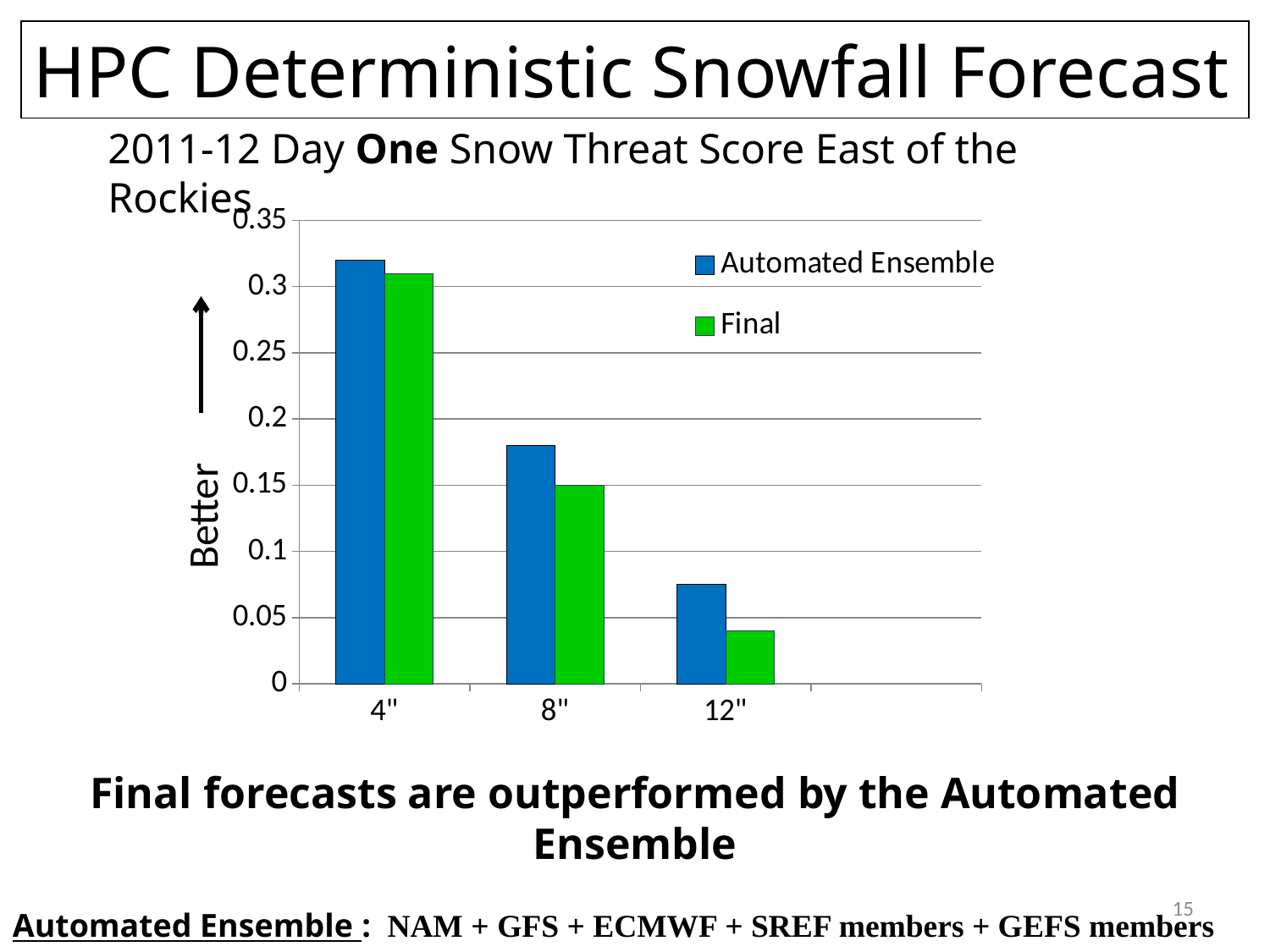
At 12", which is larger, the Automated Ensemble score or the Final score? Automated Ensemble How many snowfall categories are shown on the x axis? 3 Which snowfall category has the highest Automated Ensemble threat score? 4" What kind of chart is shown on the slide? bar chart Is the Automated Ensemble value for 12" greater or less than 0.1? less Is the Automated Ensemble value for 4" greater or less than 0.3? greater How many series does the legend list? 2 At 8", which is larger, the Automated Ensemble score or the Final score? Automated Ensemble Do the Final threat scores rise or fall as the snowfall amount increases from 4" to 12"? fall What colour are the Final bars in the chart? green Is the Final value for 12" greater or less than 0.05? less Which snowfall category has the lowest Final threat score? 12"